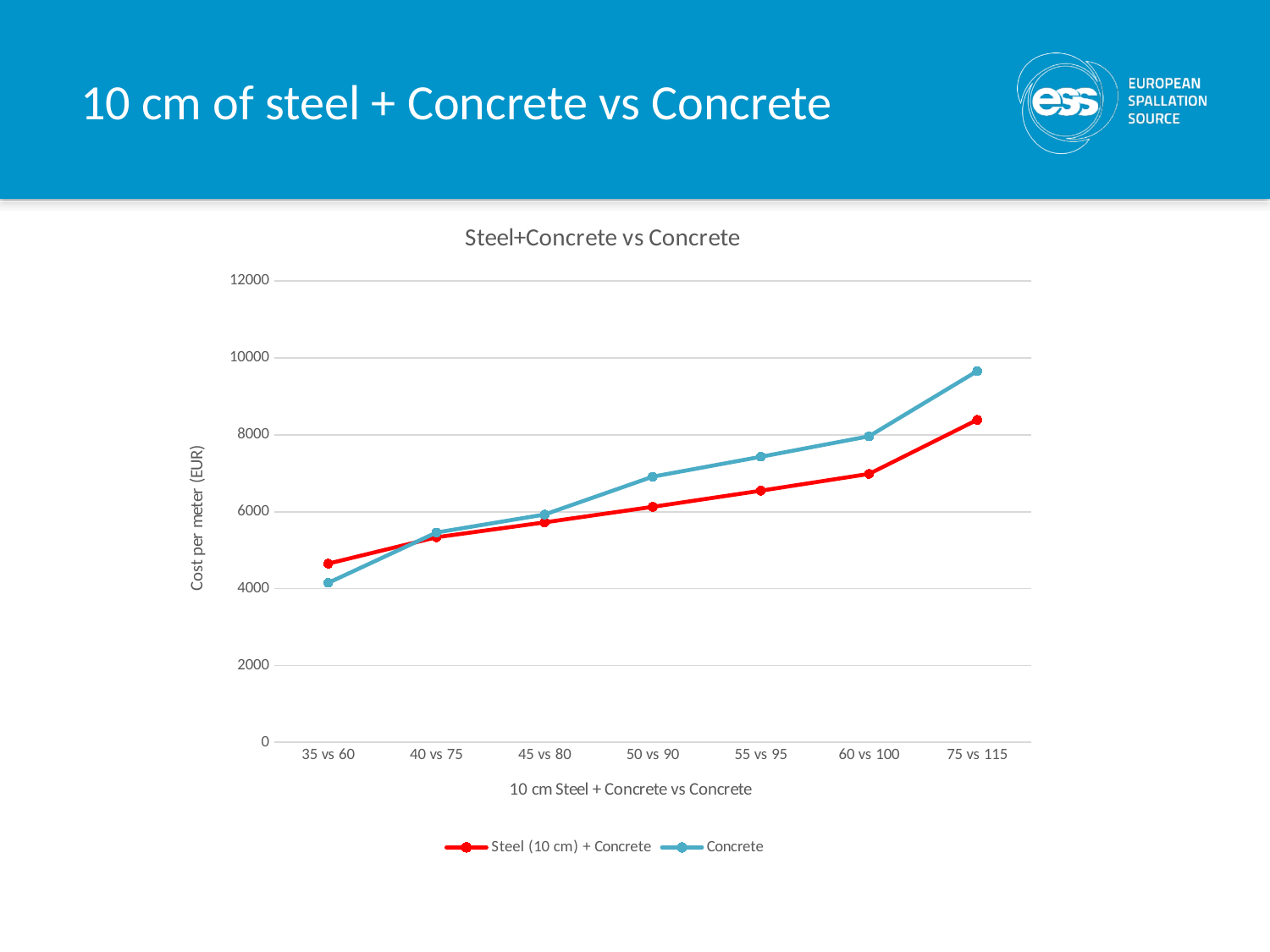
Is the value for Concrete at 50 vs 90 greater or less than 6000? greater Do the values for Concrete rise or fall from left to right along the x axis? rise Is the value for Steel (10 cm) + Concrete at 35 vs 60 greater or less than 6000? less How many categories are shown on the x axis? 7 At 75 vs 115, which series has the higher value, Steel (10 cm) + Concrete or Concrete? Concrete Is the value for Concrete at 75 vs 115 greater or less than 8000? greater What kind of chart is shown on the slide? line chart For which category is the Concrete value highest? 75 vs 115 How many series does the legend list? 2 At 35 vs 60, which series has the higher value, Steel (10 cm) + Concrete or Concrete? Steel (10 cm) + Concrete What is the title of the vertical axis? Cost per meter (EUR)